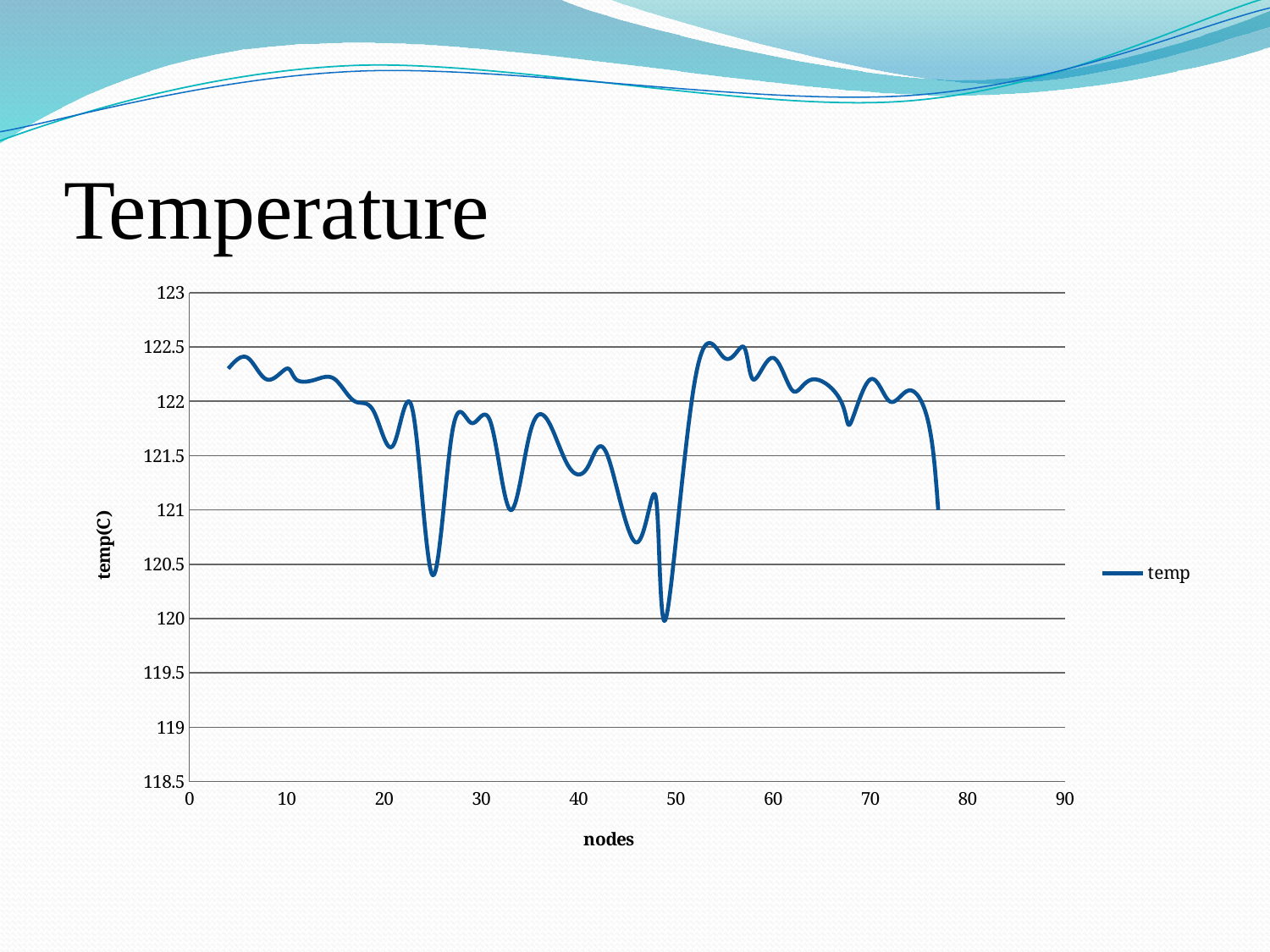
Is the lowest point of the line located between nodes 40 and 50 or between nodes 50 and 60? between nodes 40 and 50 Is the temperature at node 49 greater or less than 120.5? less Does the temperature rise or fall between node 49 and node 53? rise What kind of chart is shown on the slide? line chart Is the temperature at node 46 greater or less than 121? less What is the name of the series shown in the legend? temp Is the temperature at node 68 greater or less than 122? less Is the highest point of the line located between nodes 50 and 60 or between nodes 0 and 10? between nodes 50 and 60 What is the label of the x axis? nodes How many series does the legend list? 1